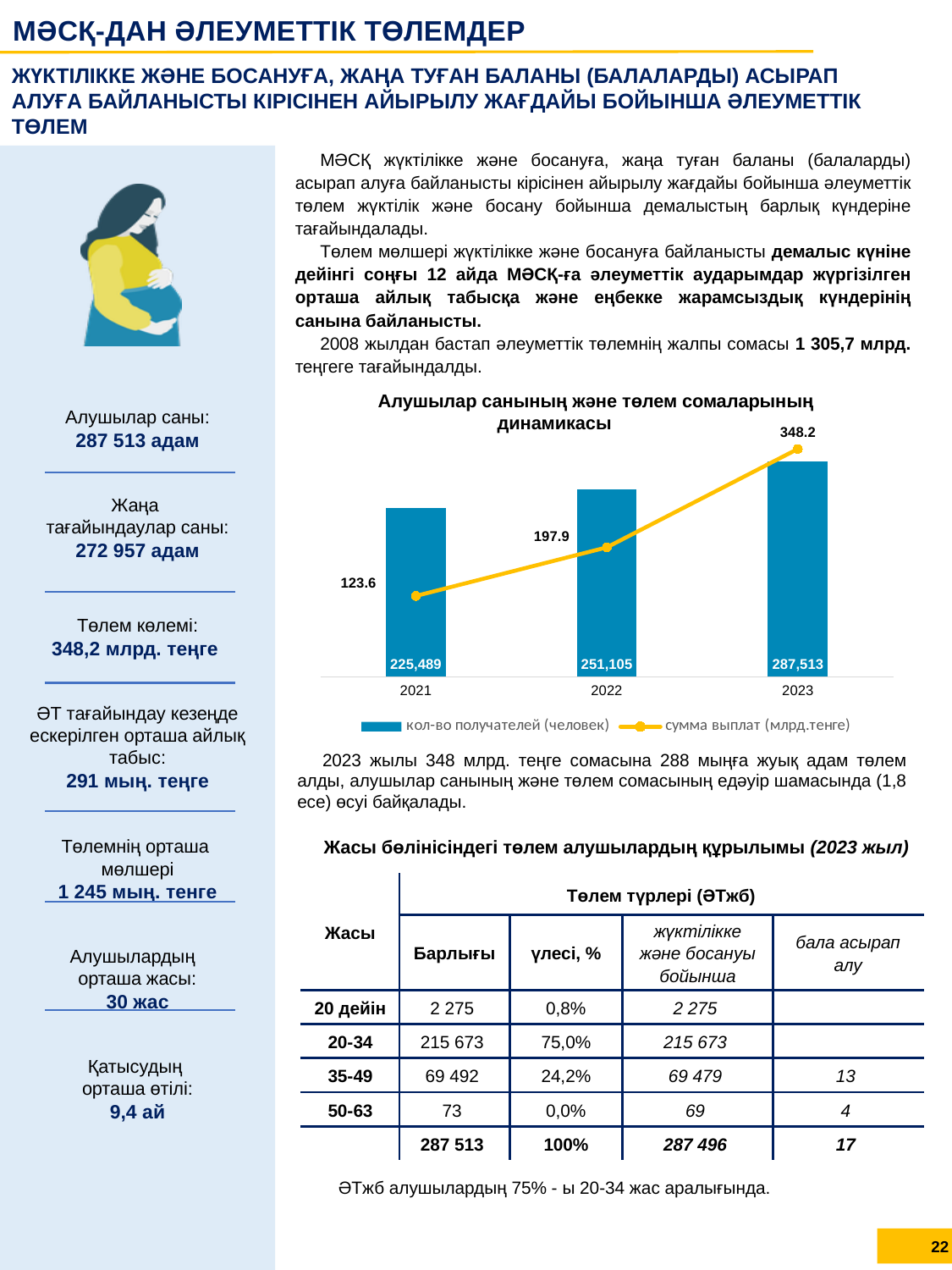
What is the number of recipients (кол-во получателей) shown for 2021? 225,489 Does the payment amount (сумма выплат) rise or fall from 2021 to 2023? rise How many series does the chart legend list? 2 What is the payment amount (сумма выплат, млрд.тенге) shown for 2021? 123.6 In which year is the number of recipients (кол-во получателей) lowest? 2021 Which year has a larger number of recipients, 2021 or 2022? 2022 In which year is the payment amount (сумма выплат) highest? 2023 By how much did the payment amount (сумма выплат, млрд.тенге) increase from 2022 to 2023? 150.3 What is the difference in the number of recipients between 2023 and 2021? 62,024 What is the payment amount (сумма выплат, млрд.тенге) shown for 2022? 197.9 What is the number of recipients (кол-во получателей) shown for 2023? 287,513 How many years are shown on the x axis of the chart? 3